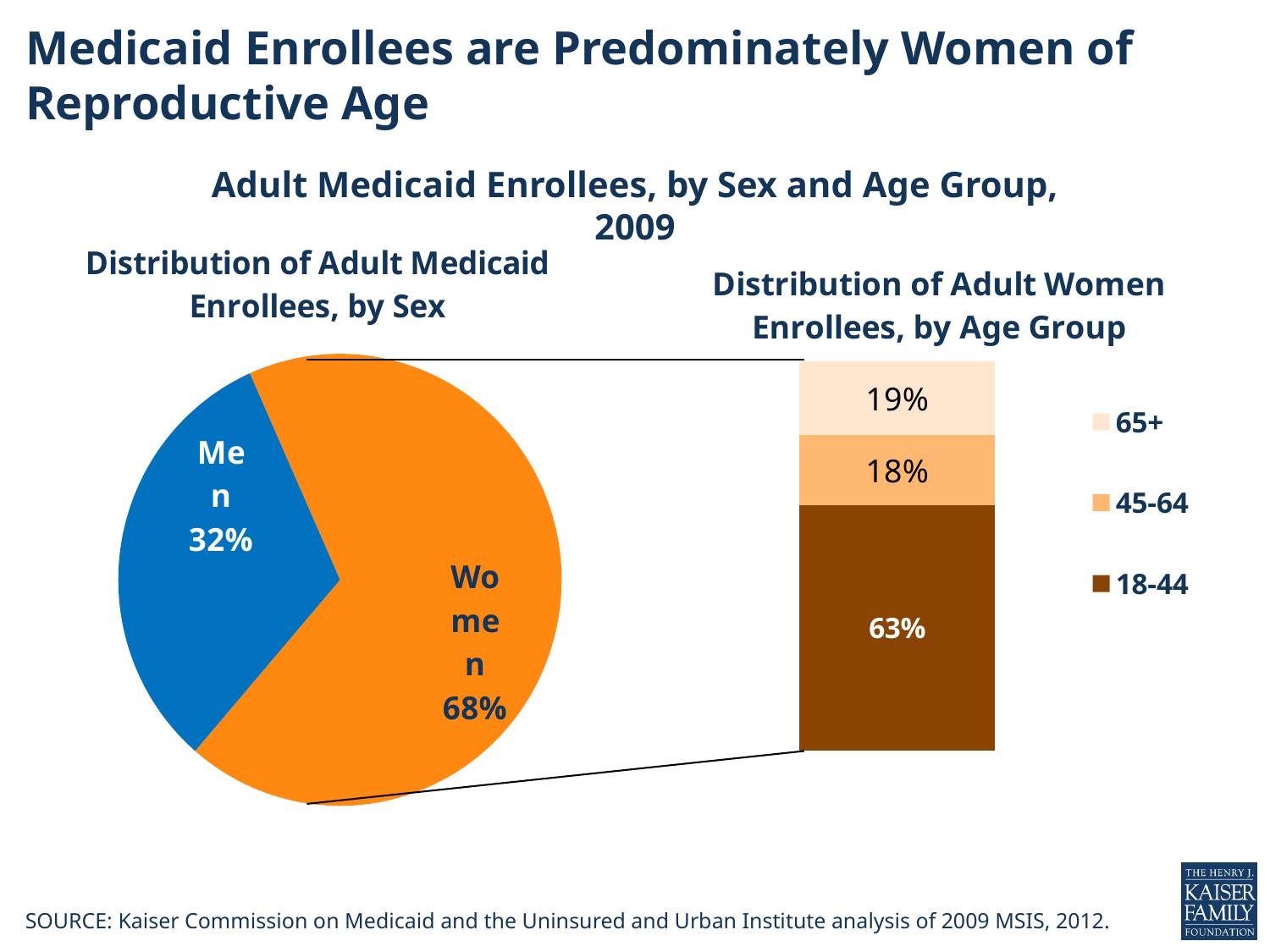
In the 'Distribution of Adult Women Enrollees, by Age Group' chart, what is the difference between the 18-44 share and the 65+ share? 44% In the 'Distribution of Adult Women Enrollees, by Age Group' chart, what percentage of adult women enrollees are aged 18-44? 63% In the 'Distribution of Adult Women Enrollees, by Age Group' chart, which age group has the largest share? 18-44 What kind of chart is the 'Distribution of Adult Women Enrollees, by Age Group' chart? Stacked bar chart In the 'Distribution of Adult Women Enrollees, by Age Group' chart, what percentage of adult women enrollees are aged 65+? 19% In the 'Distribution of Adult Women Enrollees, by Age Group' chart, what percentage of adult women enrollees are aged 45-64? 18% In the 'Distribution of Adult Medicaid Enrollees, by Sex' pie chart, what share of enrollees are women? 68% In the 'Distribution of Adult Medicaid Enrollees, by Sex' pie chart, which group has the larger share? Women How many age groups does the legend of the 'Distribution of Adult Women Enrollees, by Age Group' chart list? 3 In the 'Distribution of Adult Medicaid Enrollees, by Sex' pie chart, what is the difference between the women's share and the men's share? 36% What kind of chart is the 'Distribution of Adult Medicaid Enrollees, by Sex' chart? Pie chart In the 'Distribution of Adult Medicaid Enrollees, by Sex' pie chart, what share of enrollees are men? 32%